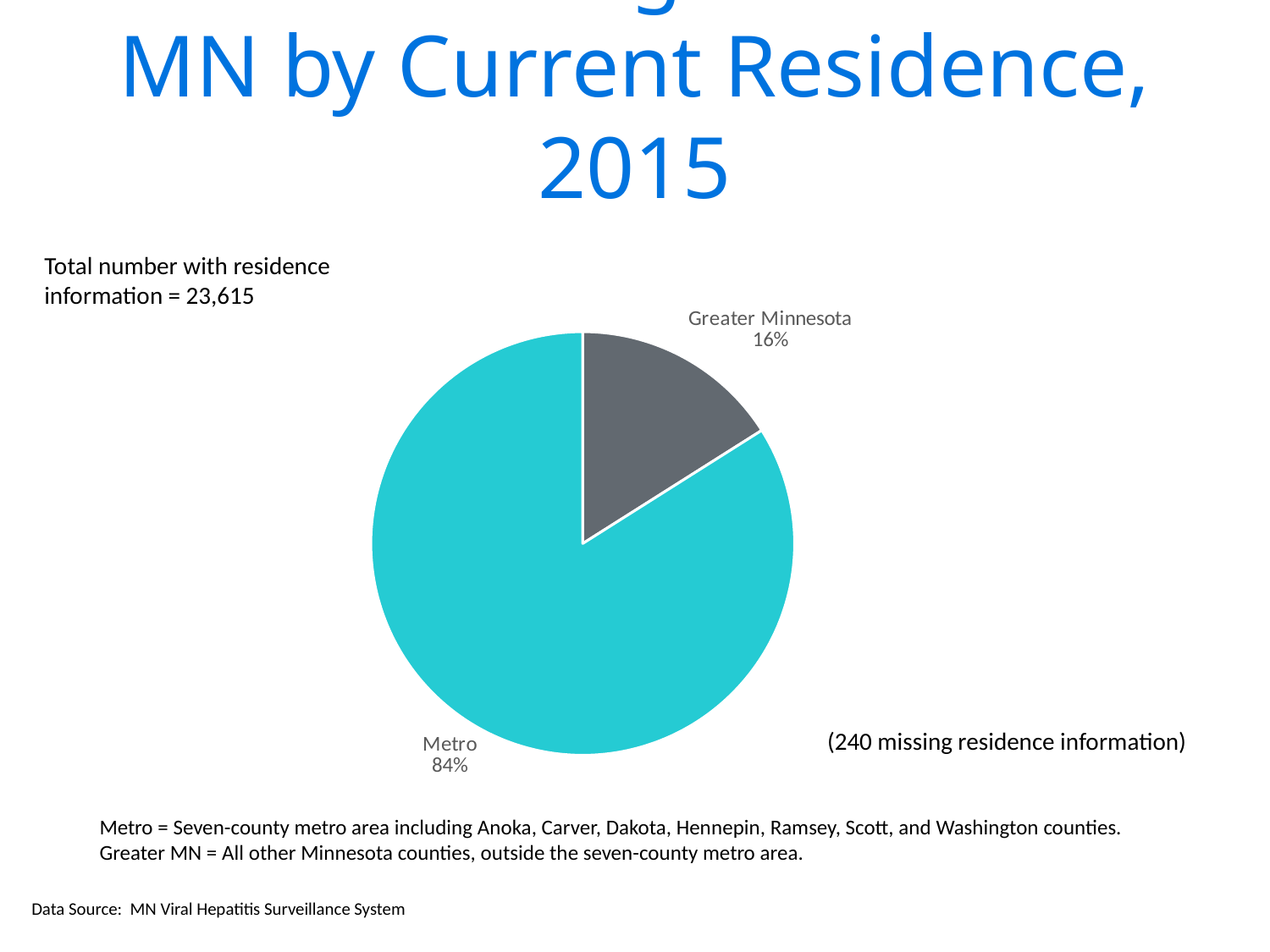
Which is larger, the Metro slice or the Greater Minnesota slice? Metro What percentage of the pie chart is Metro? 84% What colour is the Metro slice of the pie chart? Teal What kind of chart is shown on the slide? Pie chart How many slices does the pie chart have? 2 Which slice of the pie chart is the largest? Metro What is the difference in percentage points between the Metro and Greater Minnesota slices? 68 What share of the pie does the Greater Minnesota slice represent? 16% What is the total number with residence information stated on the slide? 23,615 What percentage of the pie chart is Greater Minnesota? 16% Which slice of the pie chart is the smallest? Greater Minnesota